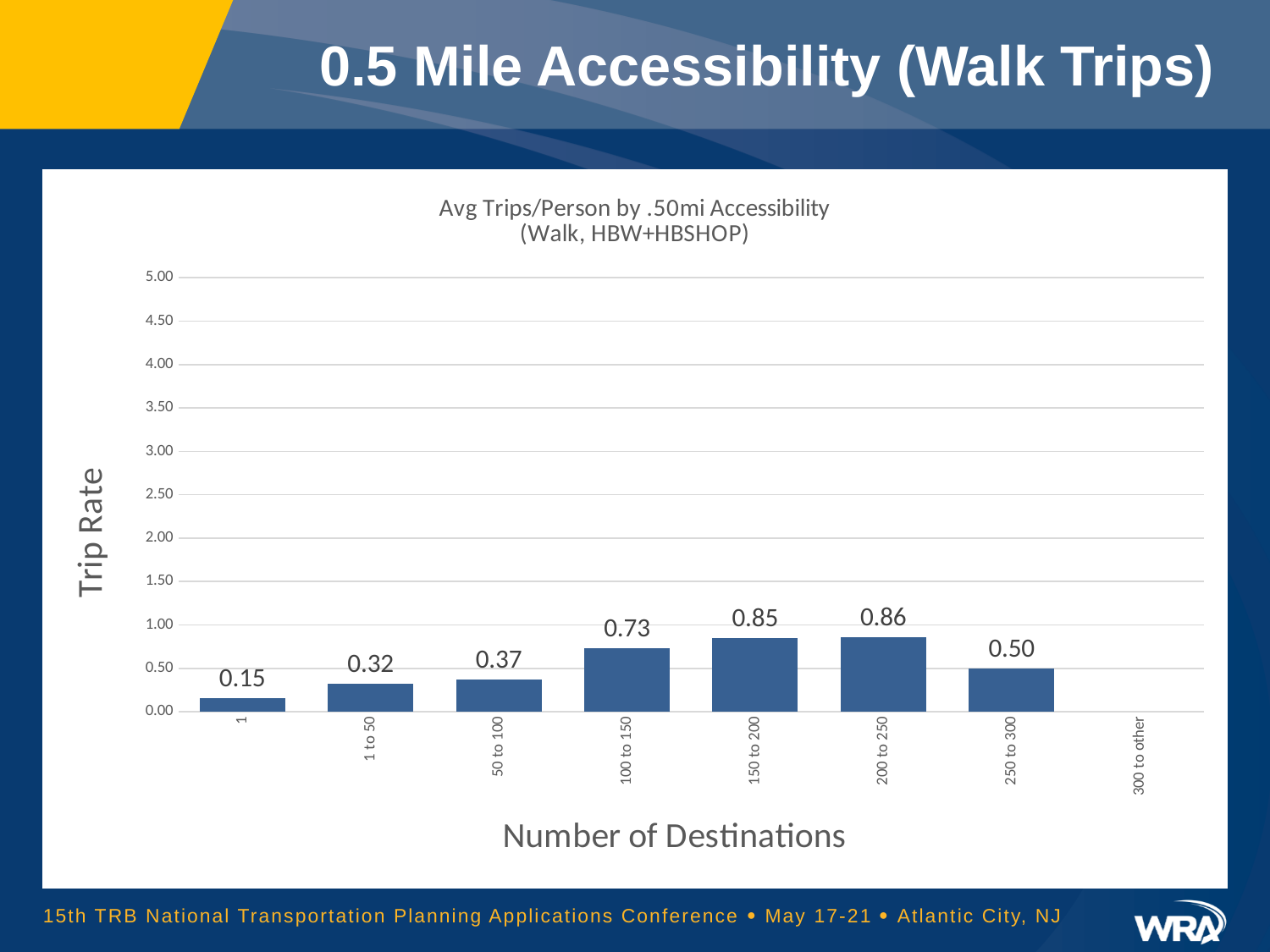
Which has a higher trip rate, '100 to 150' or '250 to 300'? 100 to 150 What type of chart is shown on the slide? Bar chart What is the title of the chart? Avg Trips/Person by .50mi Accessibility (Walk, HBW+HBSHOP) Is the trip rate for '200 to 250' greater or less than 1.00? less What is the trip rate for the '100 to 150' destinations category? 0.73 What is the trip rate for the '1 to 50' destinations category? 0.32 What is the difference in trip rate between the '150 to 200' and '50 to 100' categories? 0.48 How many number-of-destinations categories are labeled on the x axis? 8 What is the trip rate for the '250 to 300' destinations category? 0.50 What is the trip rate for the category labeled '1'? 0.15 Which number-of-destinations category has the highest trip rate? 200 to 250 What is the label of the y axis? Trip Rate